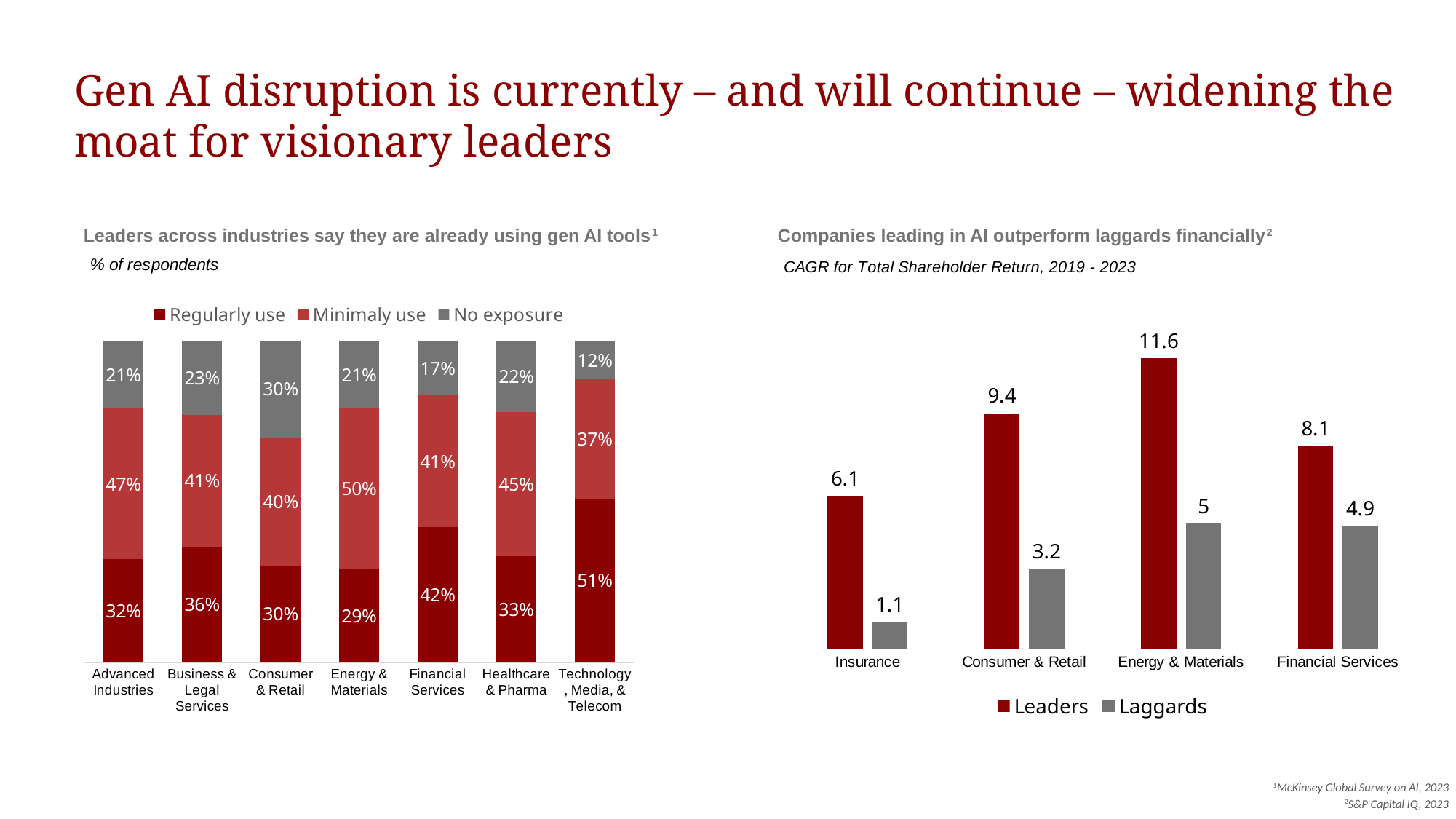
In the left chart, which industry has the lowest share of respondents with no exposure to gen AI tools? Technology, Media, & Telecom In the left chart, how many series does the legend list? 3 What type of chart is the right chart? Bar chart In the left chart (Leaders across industries say they are already using gen AI tools), what percentage of respondents in Financial Services regularly use gen AI tools? 42% In the left chart, what is the 'No exposure' percentage for Consumer & Retail? 30% In the right chart, what is the difference between Leaders and Laggards in Consumer & Retail? 6.2 In the right chart, what is the CAGR for Laggards in Insurance? 1.1 In the left chart, what is the difference between the 'Minimaly use' percentages for Energy & Materials and Technology, Media, & Telecom? 13% In the right chart, which industry has the lowest Leaders value? Insurance In the right chart (Companies leading in AI outperform laggards financially), what is the CAGR for Leaders in Energy & Materials? 11.6 In the left chart, how many industries are shown on the x axis? 7 In the left chart, which industry has the highest share of respondents who regularly use gen AI tools? Technology, Media, & Telecom